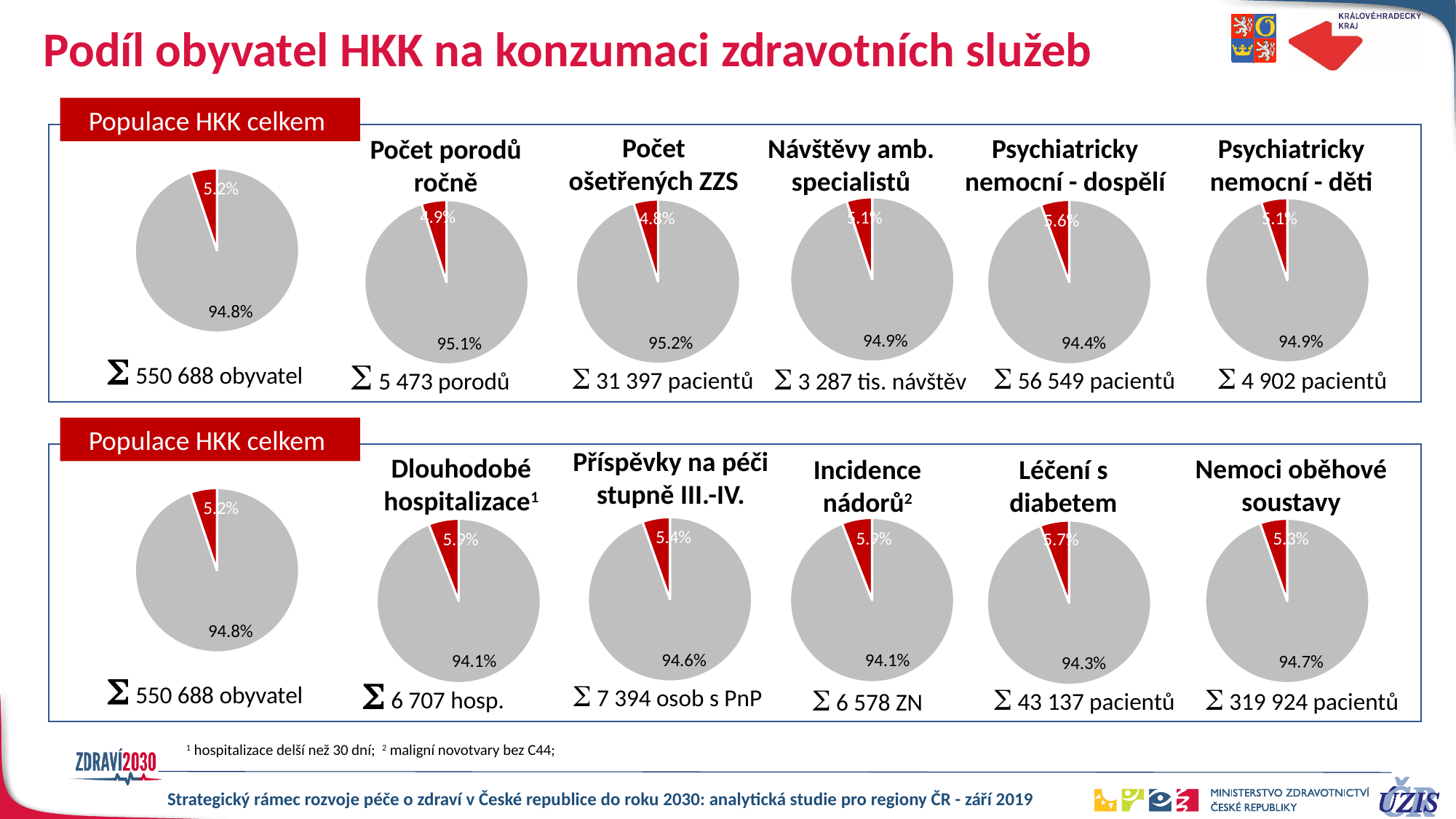
In the 'Příspěvky na péči stupně III.-IV.' pie chart, what percentage is shown for the red slice? 5.4% In the 'Léčení s diabetem' pie chart, what percentage is shown for the grey slice? 94.3% In the 'Počet ošetřených ZZS' pie chart, what percentage is shown for the grey slice? 95.2% What total is printed below the 'Počet ošetřených ZZS' pie chart? 31 397 pacientů What kind of charts are shown on the slide? Pie charts Which pie chart in the top row has the largest grey slice: 'Počet porodů ročně' or 'Počet ošetřených ZZS'? Počet ošetřených ZZS In the 'Psychiatricky nemocní - dospělí' pie chart, what percentage is shown for the red slice? 5.6% In the 'Nemoci oběhové soustavy' pie chart, what percentage is shown for the grey slice? 94.7% How many pie charts are shown in the bottom row of the slide? 6 In the 'Počet porodů ročně' pie chart, what percentage is shown for the grey slice? 95.1% What total is printed below the 'Nemoci oběhové soustavy' pie chart? 319 924 pacientů What is the difference between the grey slice percentages of the 'Psychiatricky nemocní - dospělí' and 'Psychiatricky nemocní - děti' pie charts? 0.5%